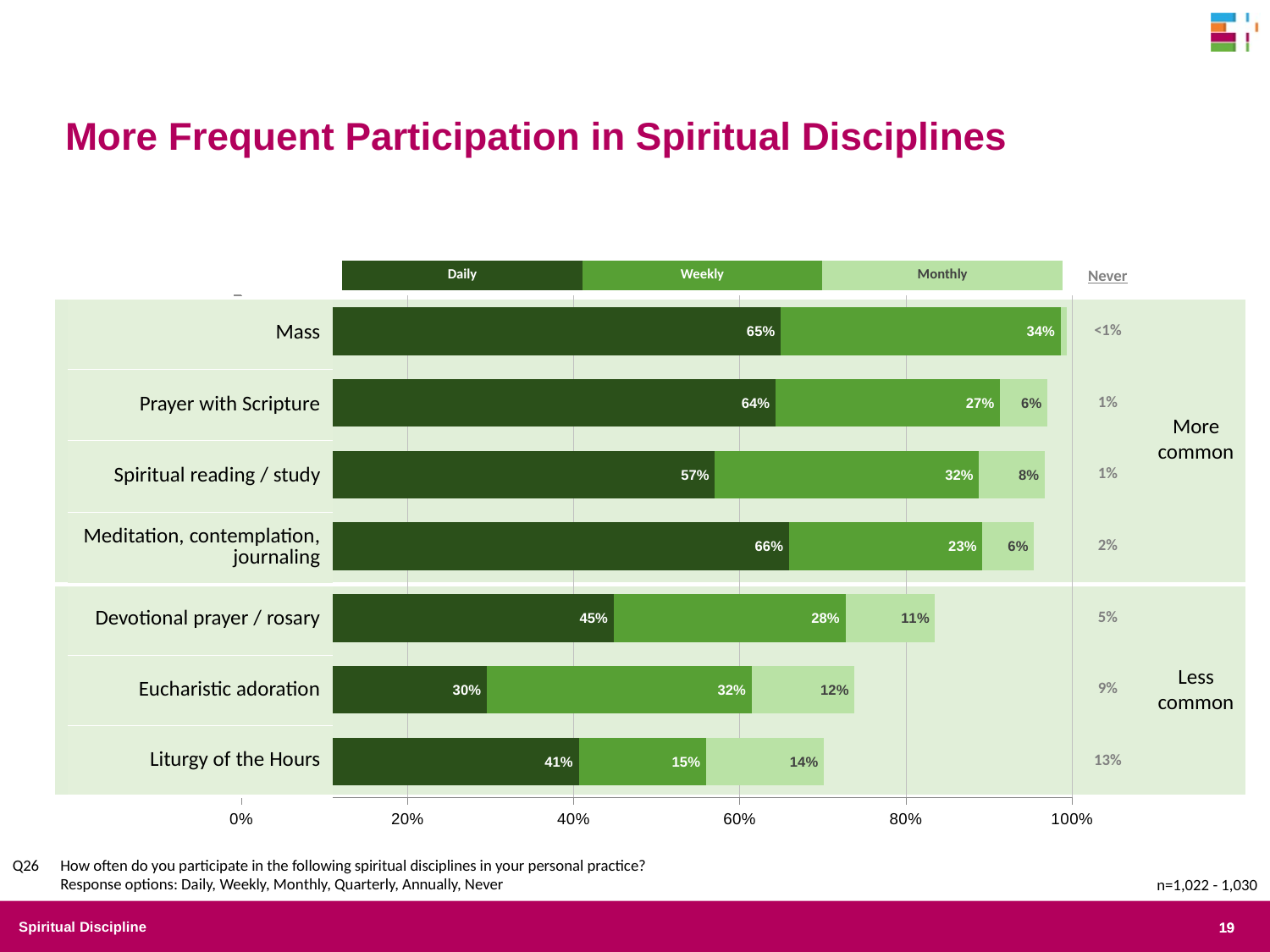
Which spiritual discipline has the highest Never value? Liturgy of the Hours What is the total of the Daily, Weekly and Monthly segments for Prayer with Scripture? 97% What is the Never value for Liturgy of the Hours? 13% What is the difference between the Daily value for Mass and the Daily value for Eucharistic adoration? 35 percentage points What percentage of respondents participate in Mass daily? 65% How many series does the chart legend list? 3 What is the Monthly value for Devotional prayer / rosary? 11% Which spiritual discipline has the lowest Daily value? Eucharistic adoration How many spiritual disciplines are shown in the chart? 7 Is the combined Daily, Weekly and Monthly bar for Liturgy of the Hours greater or less than 80%? less What is the Weekly value for Eucharistic adoration? 32% Which is larger: the Weekly value for Eucharistic adoration or the Weekly value for Liturgy of the Hours? Eucharistic adoration